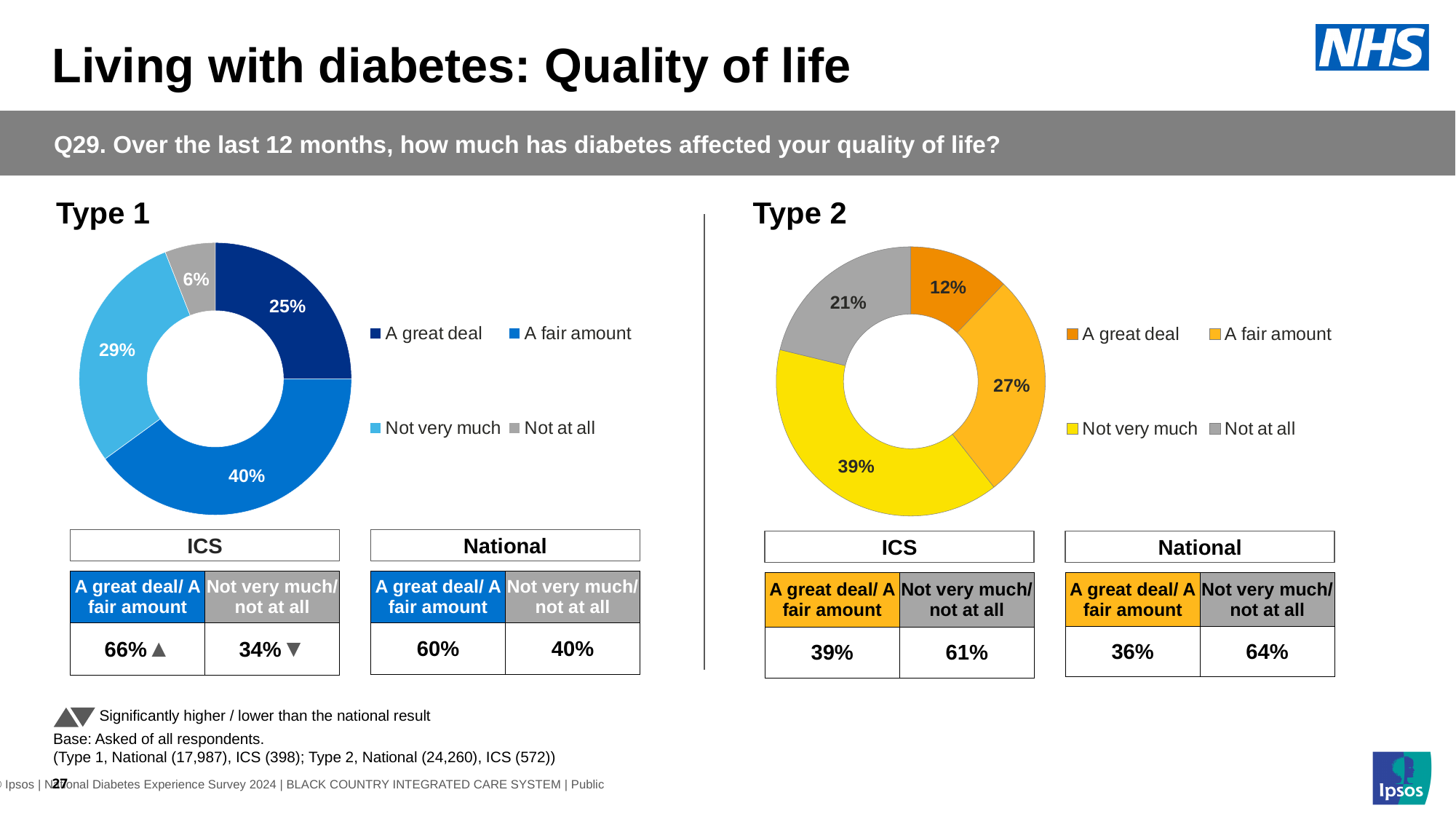
In the Type 2 chart, what is the difference between 'Not very much' and 'Not at all'? 18 percentage points In the Type 2 chart, what is the value for 'A great deal'? 12% In the Type 2 chart, which category has the smallest share? A great deal How many categories does the Type 1 chart show? 4 In the Type 1 chart, what is the value for 'Not at all'? 6% Which is larger in the Type 2 chart: 'A fair amount' or 'Not at all'? A fair amount In the Type 1 chart, which category has the largest share? A fair amount In the Type 1 chart, what colour represents 'Not very much'? Light blue In the Type 2 chart, what percentage of respondents said 'Not very much'? 39% What kind of chart is used for Type 2? Donut (pie) chart In the Type 1 chart, what is the difference between 'A fair amount' and 'A great deal'? 15 percentage points In the Type 1 chart, what percentage of respondents said diabetes affected their quality of life 'A fair amount'? 40%